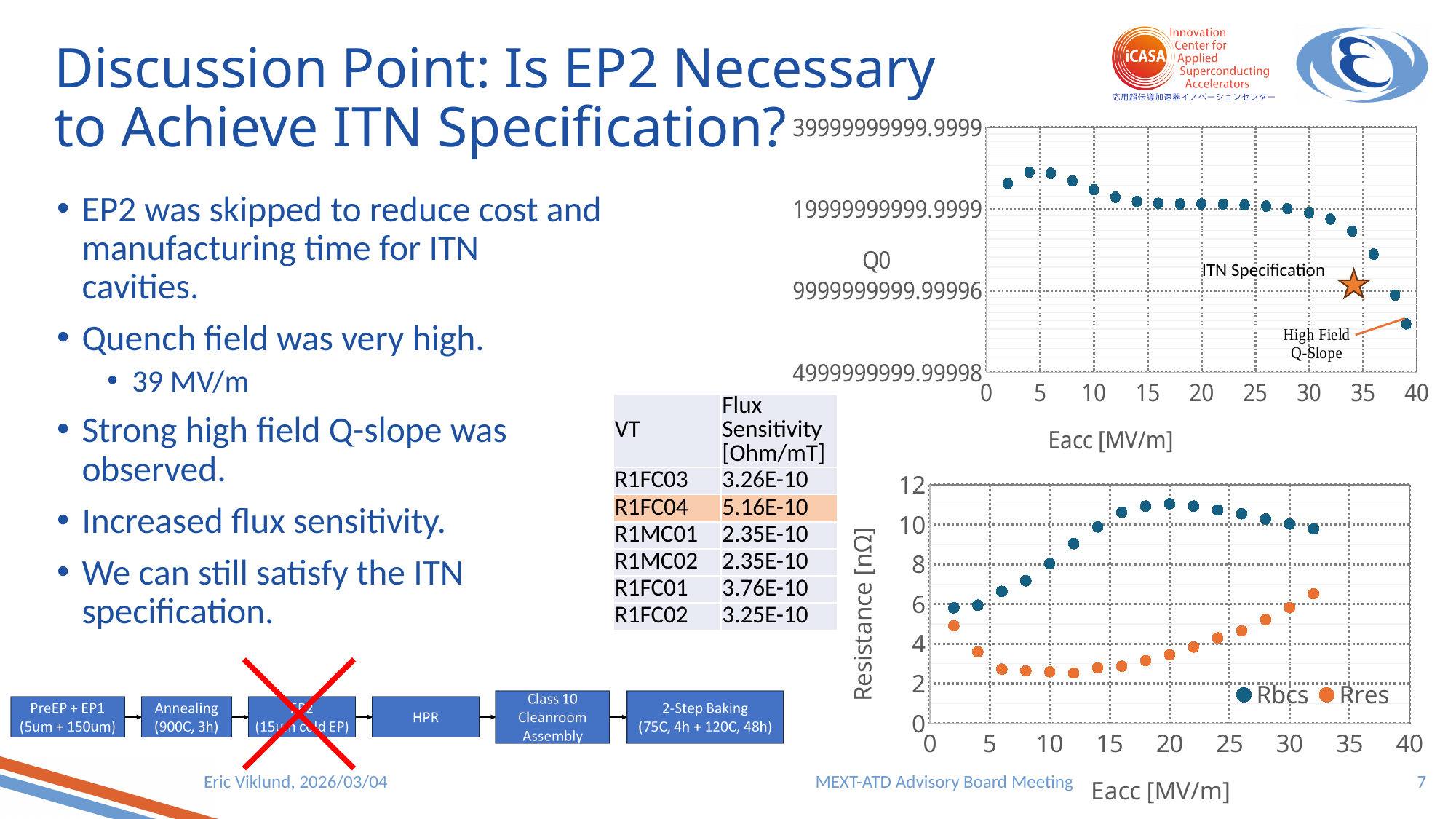
In the bottom-right Resistance chart, how many series does the legend list? 2 In the bottom-right Resistance chart, is the Rbcs value at Eacc = 20 MV/m greater or less than 10? greater In the top-right Q0 chart, what is the label of the horizontal axis? Eacc [MV/m] In the bottom-right Resistance chart, at which Eacc value is Rres highest? 32 In the bottom-right Resistance chart, how many Rbcs data points are plotted? 16 What kind of chart is the top-right chart with Q0 on the vertical axis? scatter chart In the bottom-right Resistance chart, at Eacc = 20 MV/m, which series has the larger value, Rbcs or Rres? Rbcs In the bottom-right Resistance chart, does Rres rise or fall as Eacc increases from 10 to 32 MV/m? rise In the top-right Q0 chart, what does the star marker represent? ITN Specification In the bottom-right Resistance chart, is the Rres value at Eacc = 10 MV/m greater or less than 4? less In the top-right Q0 chart, does Q0 rise or fall as Eacc increases from 10 to 40 MV/m? fall In the bottom-right Resistance chart, what are the two series named in the legend? Rbcs and Rres